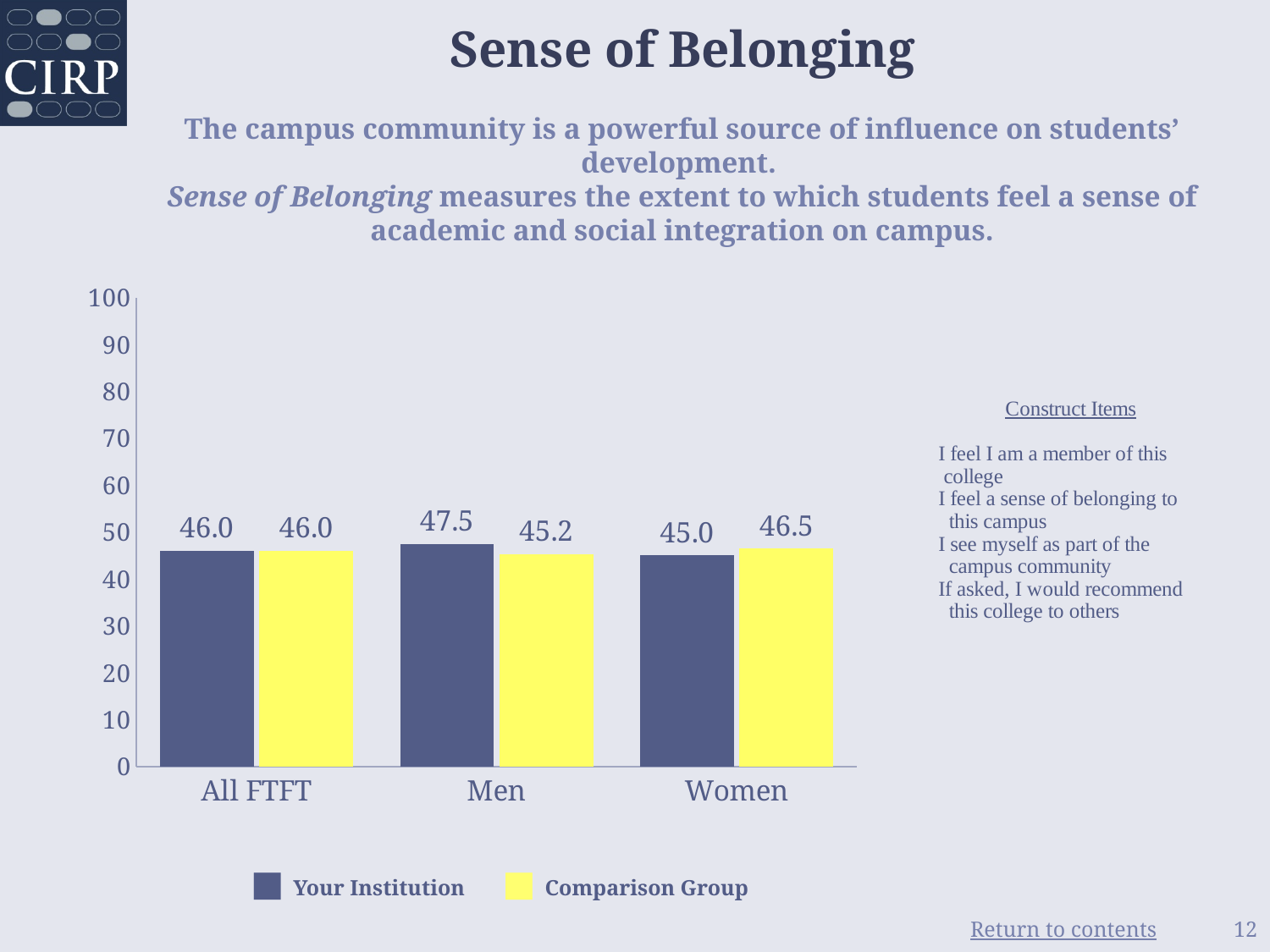
For Women, which is larger: Your Institution or Comparison Group? Comparison Group Is the Your Institution value for Men greater or less than 40? greater Which category has the lowest Comparison Group value? Men What is the Your Institution value for All FTFT? 46.0 What kind of chart is shown on the slide? bar chart What is the Your Institution value for Men? 47.5 What is the difference between the Your Institution and Comparison Group values for Men? 2.3 How many categories are shown on the x axis? 3 What is the Comparison Group value for Women? 46.5 Which category has the highest Your Institution value? Men How many series does the legend list? 2 What is the difference between the Comparison Group and Your Institution values for Women? 1.5